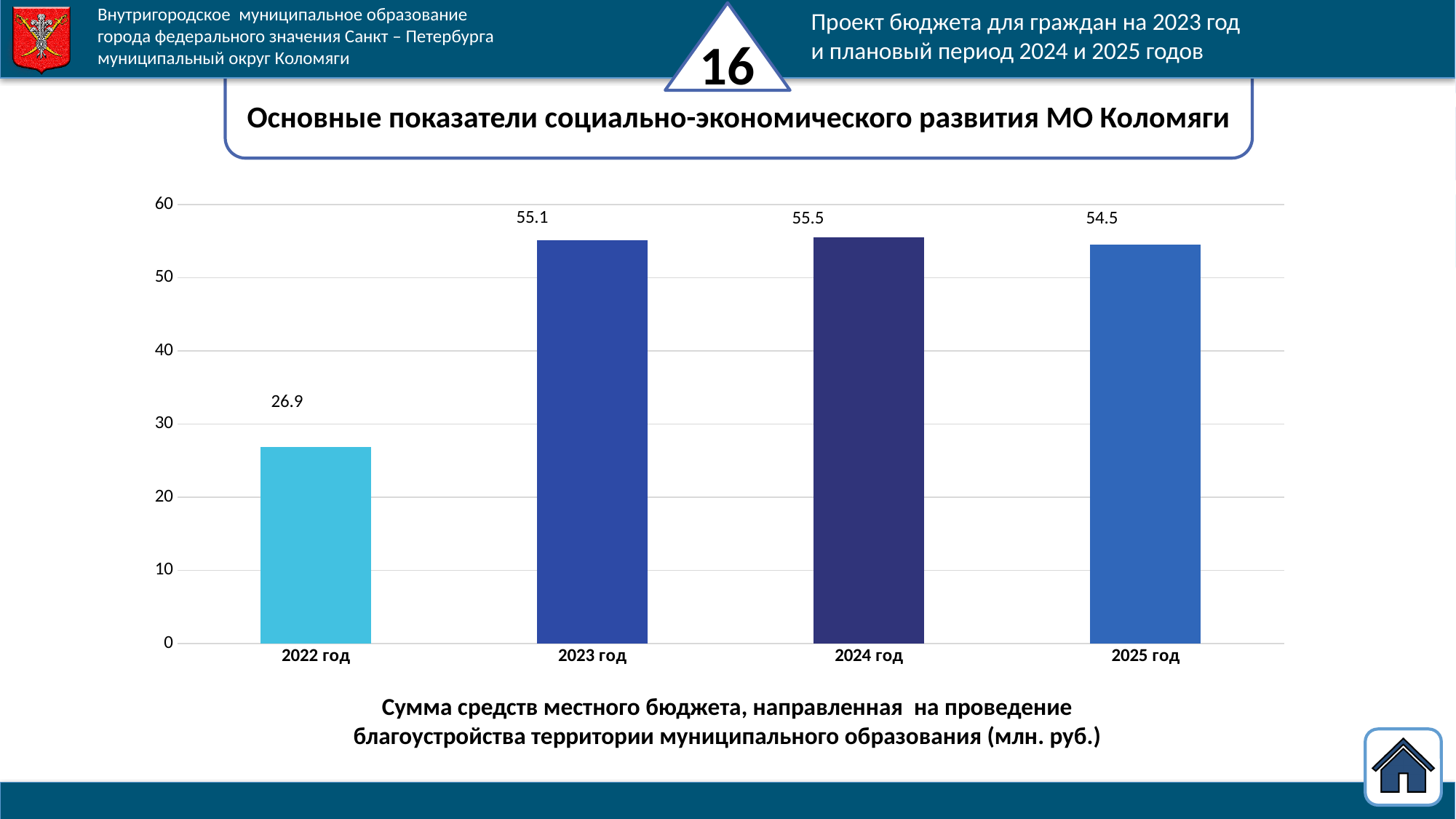
Which year has the highest value? 2024 год Which year has the lowest value? 2022 год What unit is given in the caption below the chart? млн. руб. What is the value for 2025 год? 54.5 How many years are shown on the chart? 4 What is the value for 2024 год? 55.5 Is the value for 2022 год greater or less than 30? less What kind of chart is shown on the slide? bar chart What is the value for 2022 год? 26.9 What is the difference between the values for 2024 год and 2025 год? 1 What is the difference between the values for 2023 год and 2022 год? 28.2 Which is larger, the value for 2022 год or the value for 2025 год? 2025 год